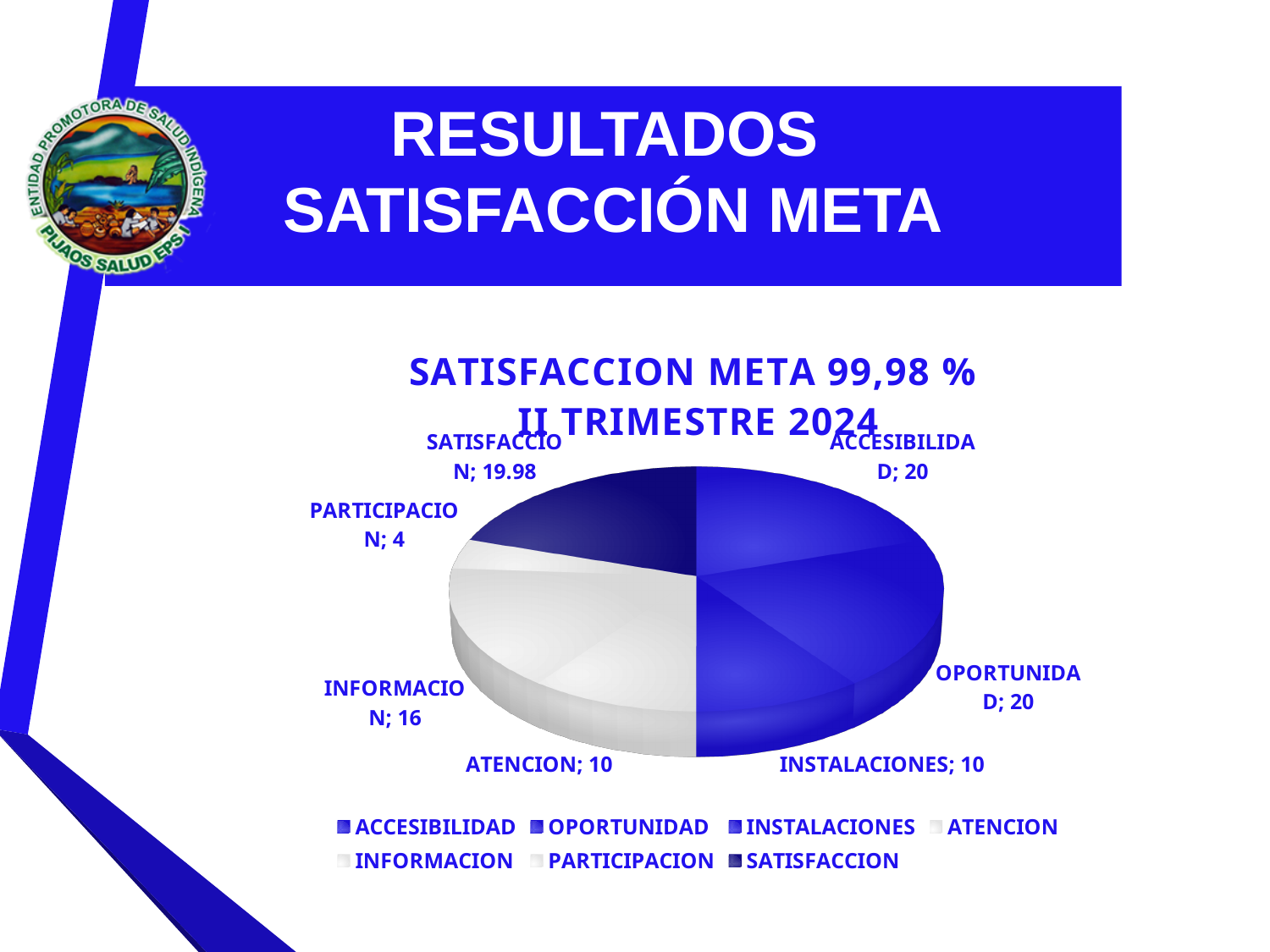
What is the title of the chart? SATISFACCION META 99,98 % II TRIMESTRE 2024 What is the value for INFORMACION in the pie chart? 16 What is the difference between the values for ACCESIBILIDAD and PARTICIPACION? 16 Which category has the smallest slice in the pie chart? PARTICIPACION What is the value for SATISFACCION in the pie chart? 19.98 What kind of chart is shown on the slide? Pie chart What is the value for ACCESIBILIDAD in the pie chart? 20 What is the difference between the values for INFORMACION and ATENCION? 6 How many entries does the legend list? 7 What is the value for PARTICIPACION in the pie chart? 4 How many categories are shown in the pie chart? 7 Which is larger, the value for INFORMACION or the value for INSTALACIONES? INFORMACION